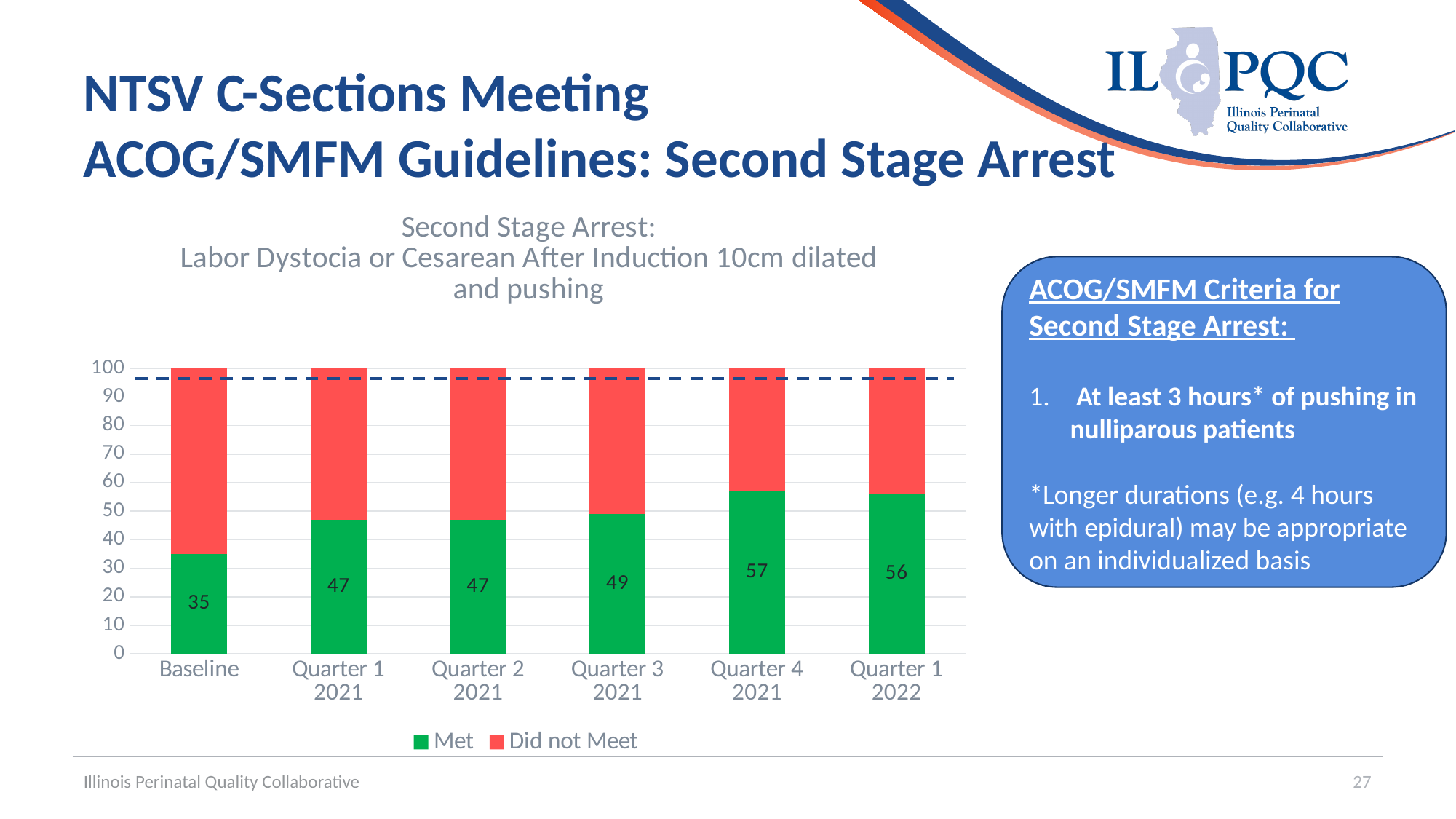
Does the Met value rise or fall from Baseline to Quarter 4 2021? Rise What kind of chart is shown on the slide? Stacked bar chart Which colour represents the Did not Meet series? Red Which category has the lowest Met value? Baseline How many categories are shown on the x axis? 6 Which has a larger Met value, Quarter 2 2021 or Quarter 3 2021? Quarter 3 2021 What is the value for Met in the Baseline bar? 35 What is the value for Met in Quarter 4 2021? 57 Which category has the highest Met value? Quarter 4 2021 How many series does the legend list? 2 What is the difference between the Met value for Quarter 4 2021 and the Met value for Baseline? 22 Is the Did not Meet value for Baseline greater or less than 60? greater